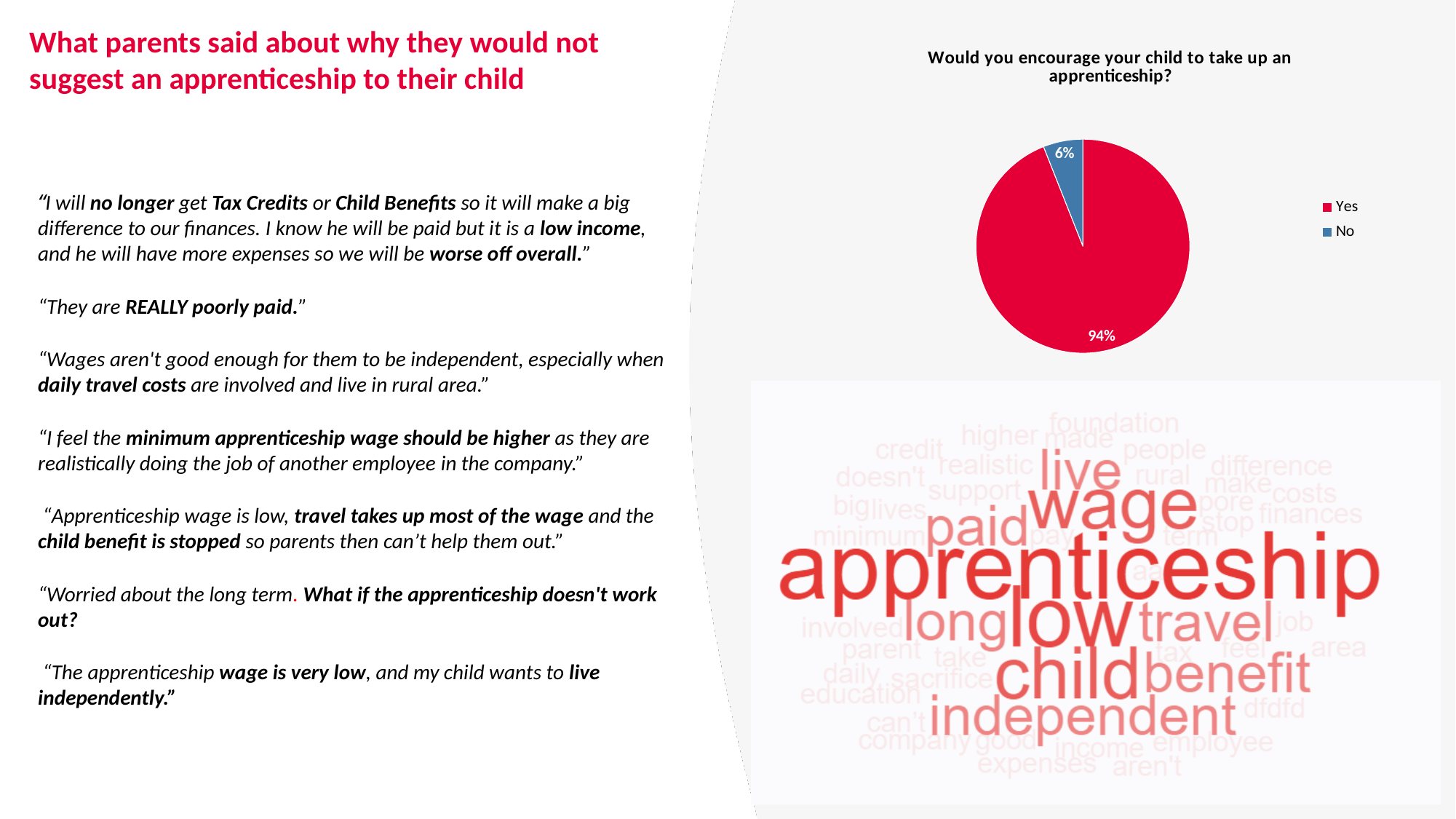
What is the difference in percentage points between the Yes and No slices? 88 Which slice of the pie chart is the smallest? No What is the title of the pie chart? Would you encourage your child to take up an apprenticeship? What kind of chart is shown on the slide? pie chart What colour is the Yes slice in the pie chart? red Which is larger, the Yes slice or the No slice? Yes Which slice of the pie chart is the largest? Yes What share of the pie is labelled No? 6% What share of the pie is labelled Yes? 94% How many entries does the legend of the pie chart list? 2 How many slices does the pie chart have? 2